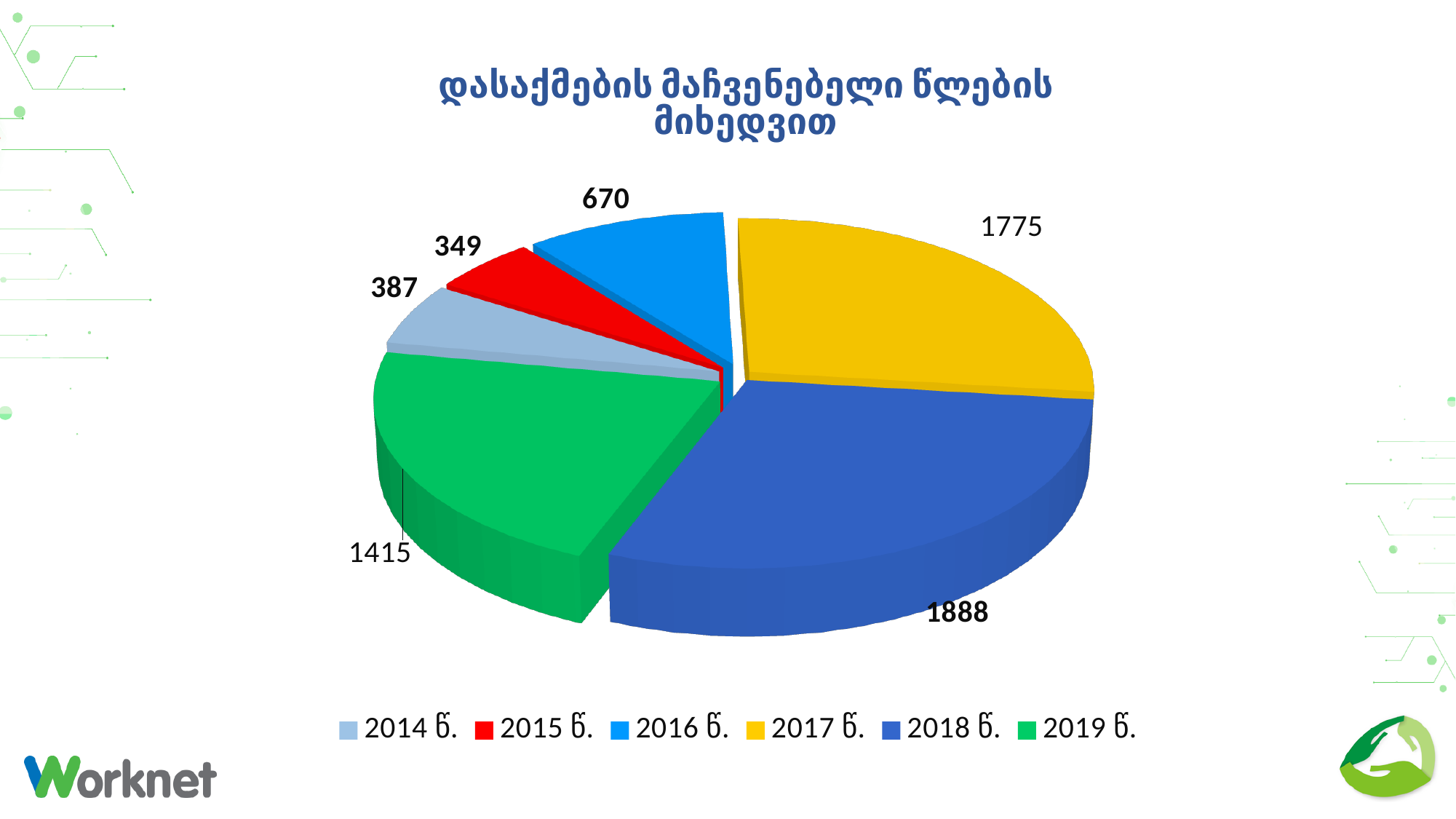
Which year has the smallest slice? 2015 წ. What is the value for 2016 წ.? 670 What is the value for 2014 წ.? 387 What is the value for 2018 წ.? 1888 Which is larger, the value for 2019 წ. or the value for 2017 წ.? 2017 წ. What type of chart is shown on the slide? Pie chart What is the difference between the values for 2018 წ. and 2017 წ.? 113 Which year has the largest slice? 2018 წ. What is the difference between the values for 2016 წ. and 2015 წ.? 321 What colour is the slice for 2019 წ.? Green How many slices does the pie chart have? 6 What is the total of all the slices in the pie chart? 6484